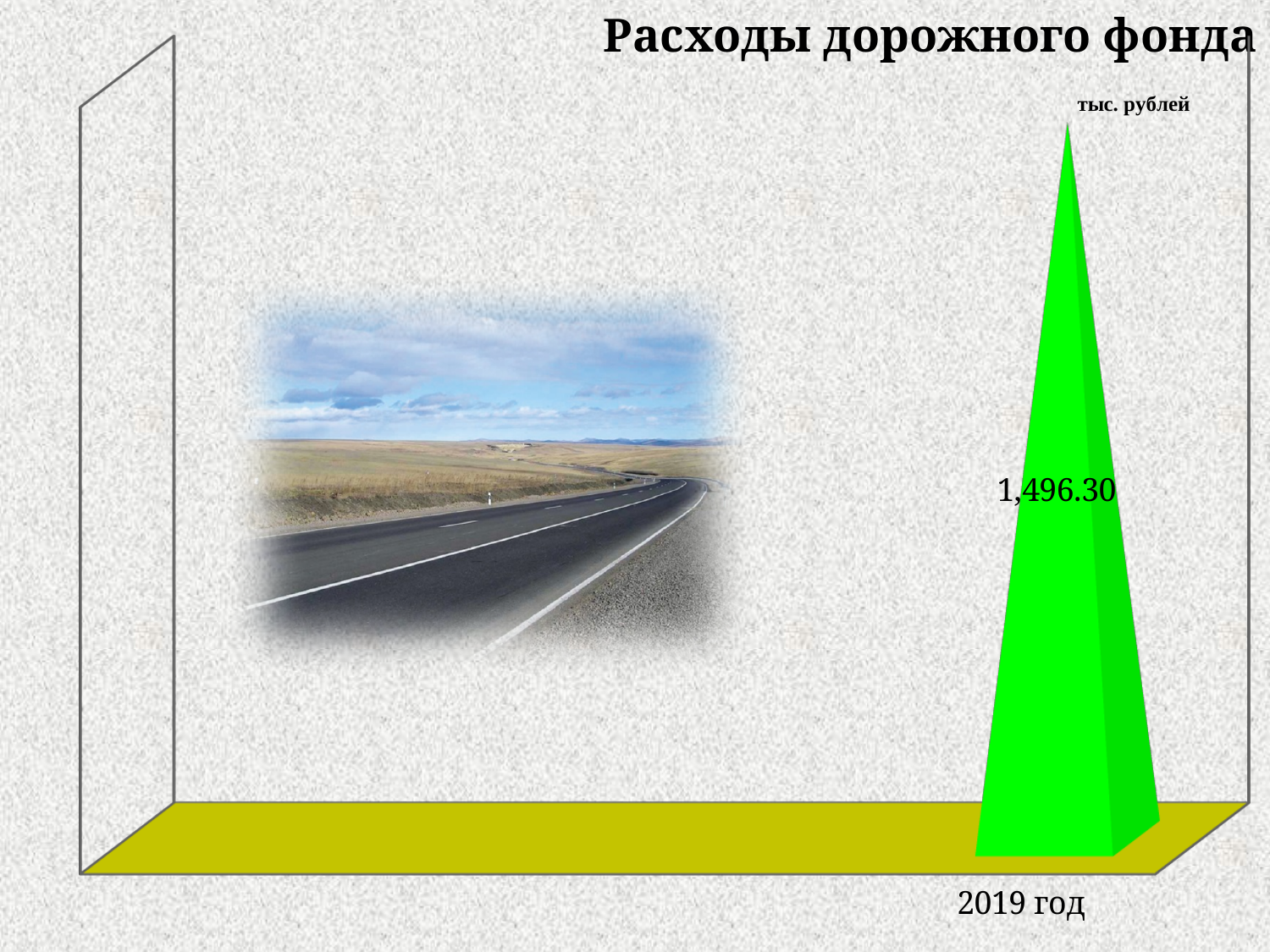
How many categories are plotted on the chart? 1 Which year is labelled on the x axis of the chart? 2019 год What is the value shown for 2019 год? 1,496.30 What is the title of the chart? Расходы дорожного фонда What unit is indicated for the values on the chart? тыс. рублей What kind of chart is shown on the slide? bar chart